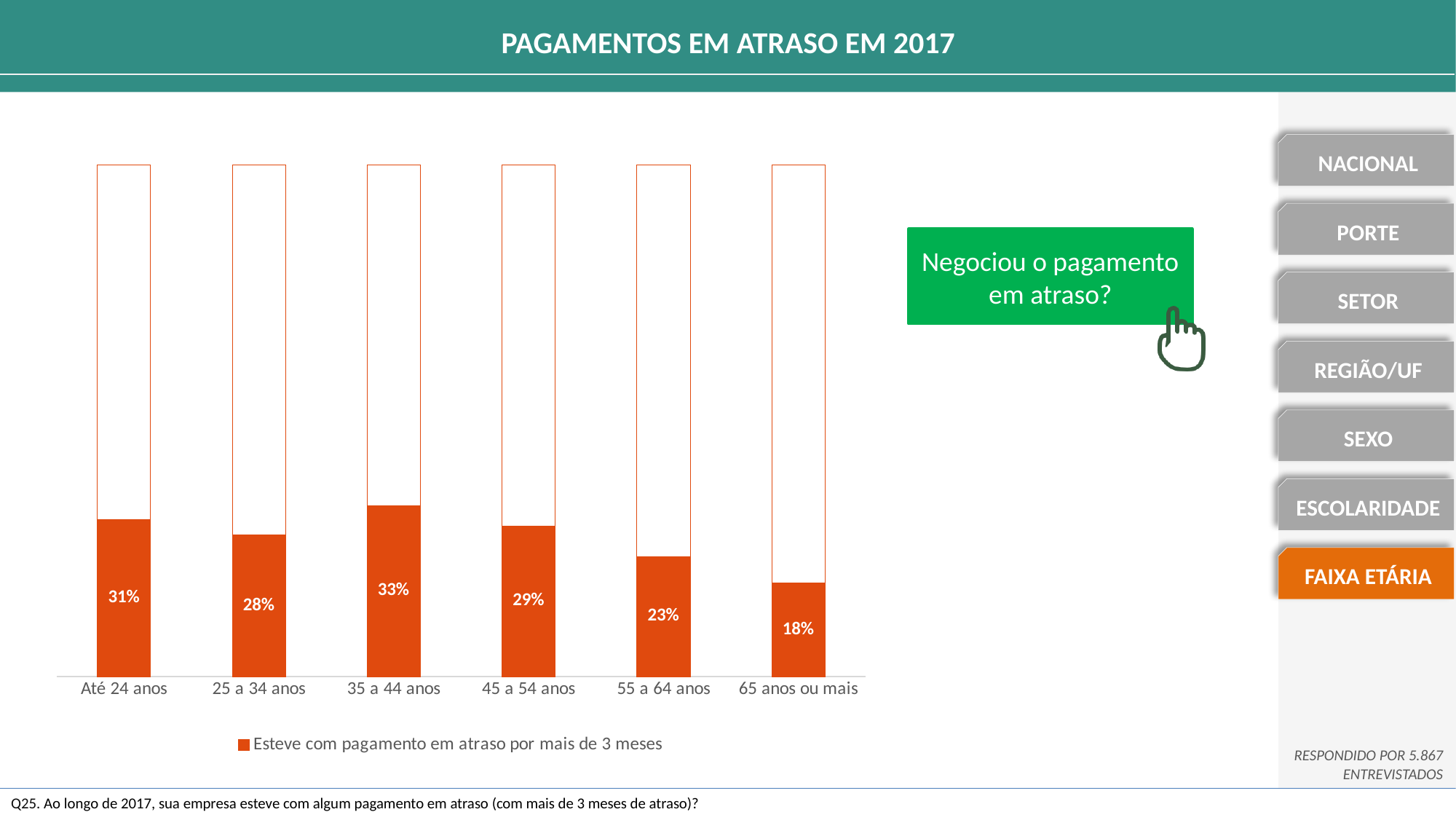
What is the legend entry for the orange series? Esteve com pagamento em atraso por mais de 3 meses What is the difference between the values for '35 a 44 anos' and '65 anos ou mais'? 15% What is the value for '65 anos ou mais'? 18% What is the value for '55 a 64 anos'? 23% How many series does the legend list? 1 Which is larger, the value for '25 a 34 anos' or '45 a 54 anos'? 45 a 54 anos Which age group has the lowest value? 65 anos ou mais What kind of chart is shown? bar chart What is the value for 'Até 24 anos'? 31% Do the values rise or fall from '35 a 44 anos' to '65 anos ou mais'? fall How many age groups are shown on the chart? 6 Which age group has the highest value? 35 a 44 anos